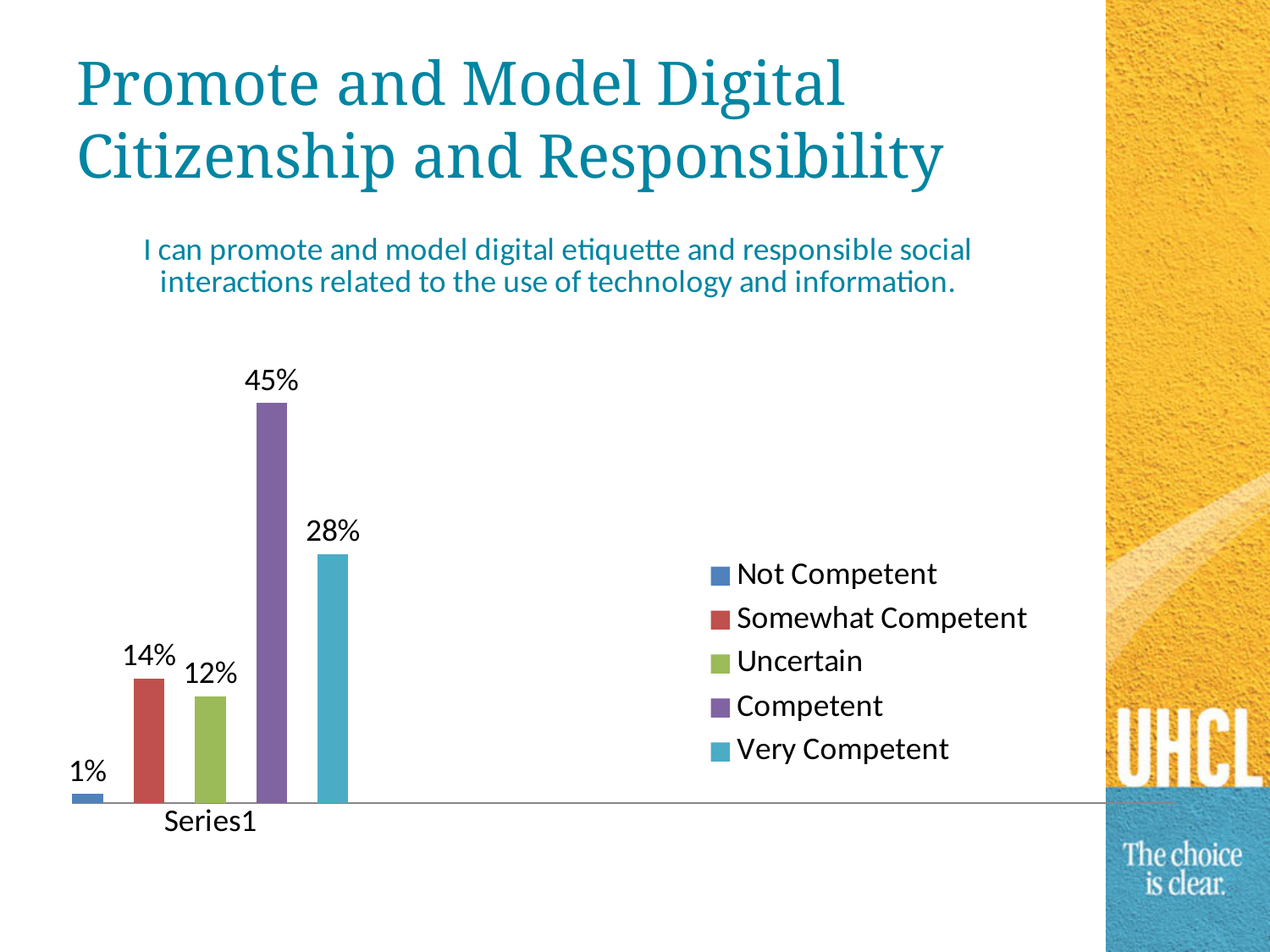
Which category has the highest value? Competent Which category has the lowest value? Not Competent What is the value for Very Competent? 28% What percentage of respondents rated themselves as Competent? 45% What kind of chart is shown on the slide? Bar chart What colour is the bar for Competent? Purple How many series does the legend list? 5 What is the value for Uncertain? 12% What is the difference between the Competent and Very Competent values? 17% What is the difference between the Somewhat Competent and Uncertain values? 2% Which is larger, the value for Somewhat Competent or the value for Uncertain? Somewhat Competent What is the value for Not Competent? 1%